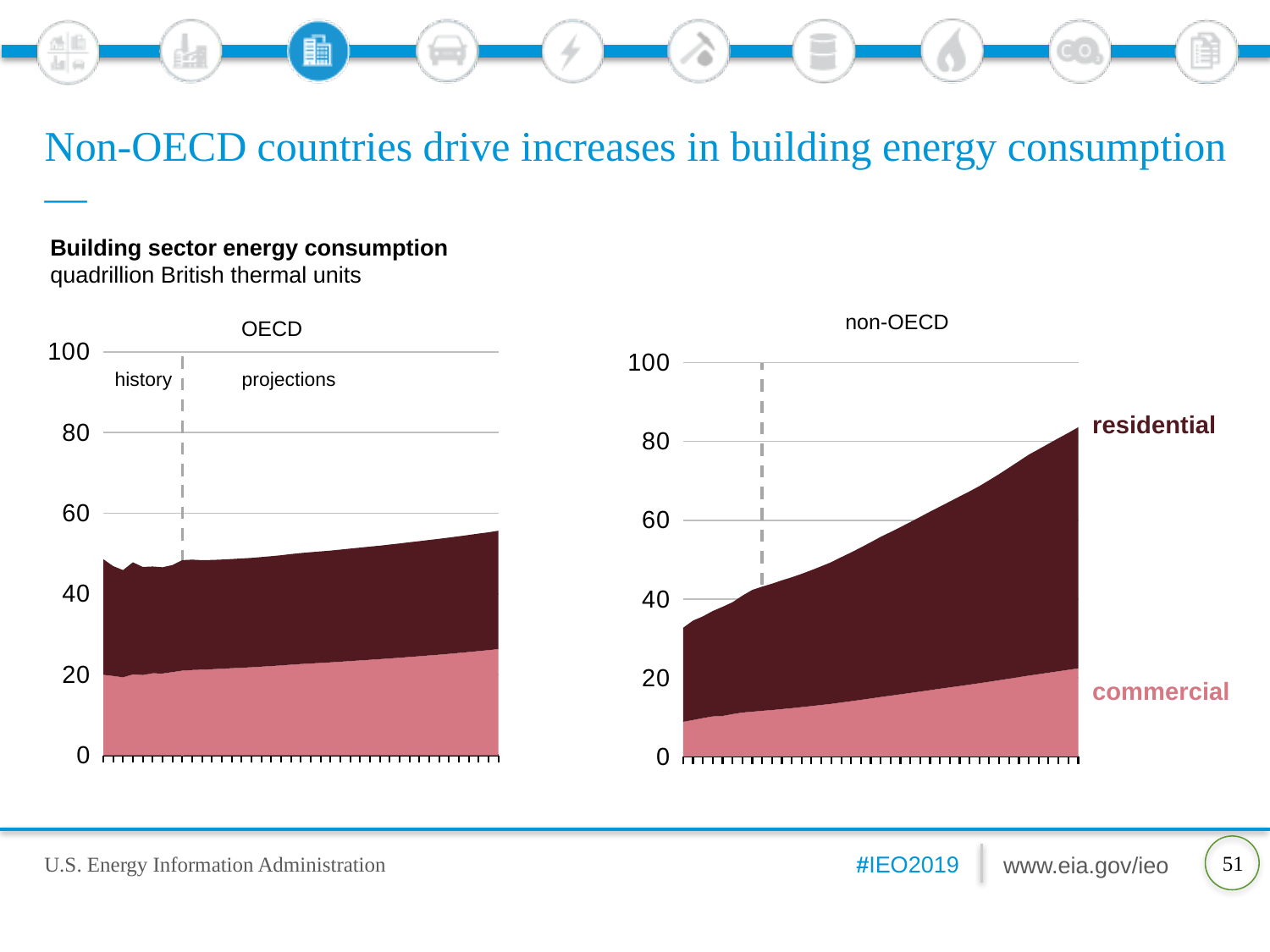
On the non-OECD chart, is the total building energy consumption at the end of the projections greater or less than 60? greater What are the two series shown on the non-OECD chart? residential and commercial On the non-OECD chart, which series is larger at the end of the projections, residential or commercial? residential On the non-OECD chart, does total building energy consumption rise or fall over the projection period? rise What kind of chart is the non-OECD chart? stacked area chart What kind of chart is the OECD chart? stacked area chart On the OECD chart, does total building energy consumption rise or fall over the projection period? rise At the end of the projections, which chart shows higher total building energy consumption, OECD or non-OECD? non-OECD What unit is used for the building sector energy consumption charts? quadrillion British thermal units On the OECD chart, is the total building energy consumption at the end of the projections greater or less than 60? less On the non-OECD chart, is commercial energy consumption at the end of the projections greater or less than 40? less How many series are labelled on the non-OECD chart? 2